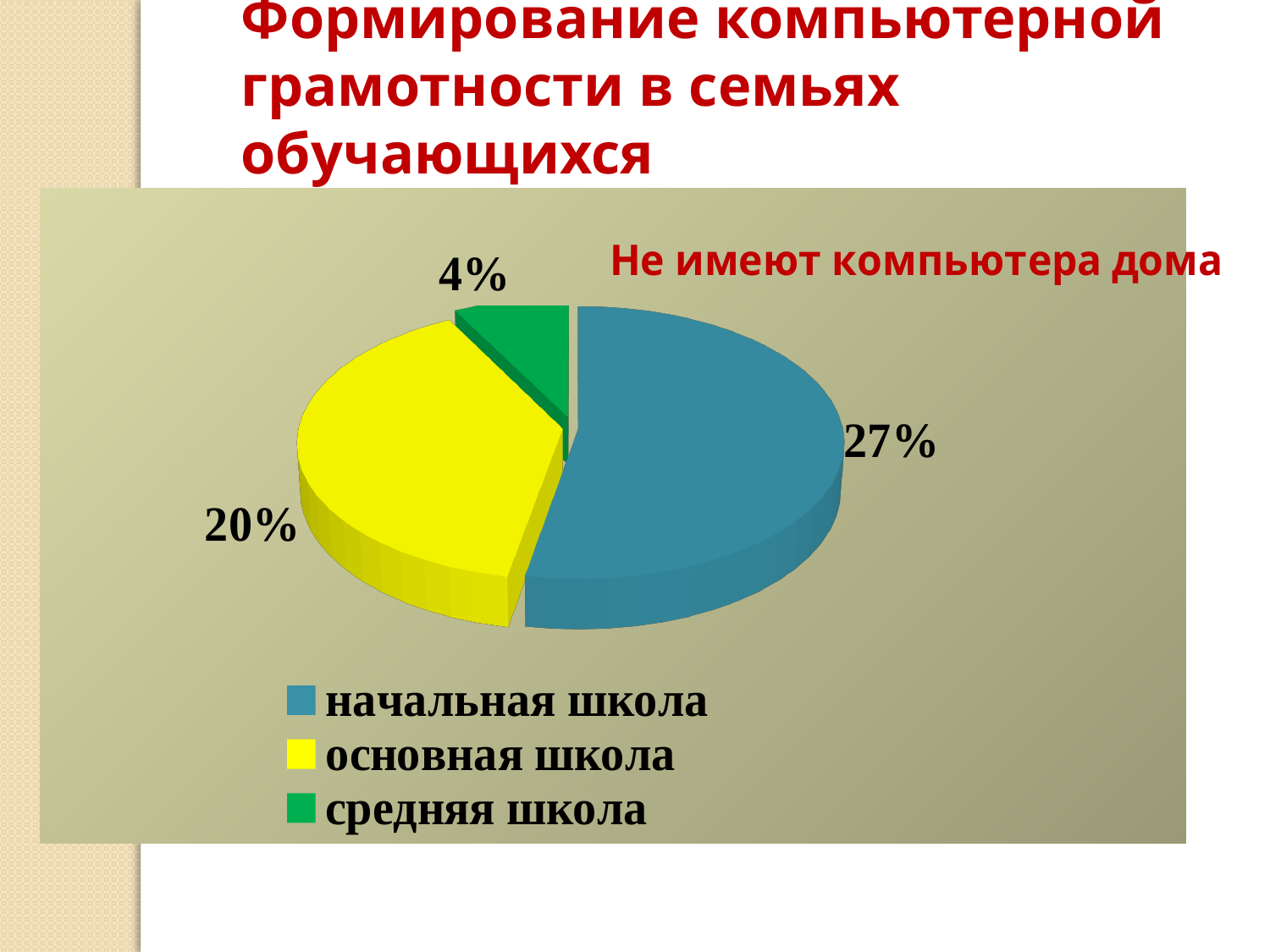
What is the value shown for начальная школа? 27% What is the title of the chart? Не имеют компьютера дома Which colour represents основная школа in the chart? yellow How many categories does the pie chart have? 3 What is the difference between the values for начальная школа and основная школа? 7% What kind of chart is shown on the slide? pie chart Which category has the largest slice of the pie? начальная школа What is the difference between the values for основная школа and средняя школа? 16% Which category has the smallest slice of the pie? средняя школа What is the value shown for основная школа? 20% What is the value shown for средняя школа? 4% Which is larger, the value for основная школа or the value for средняя школа? основная школа